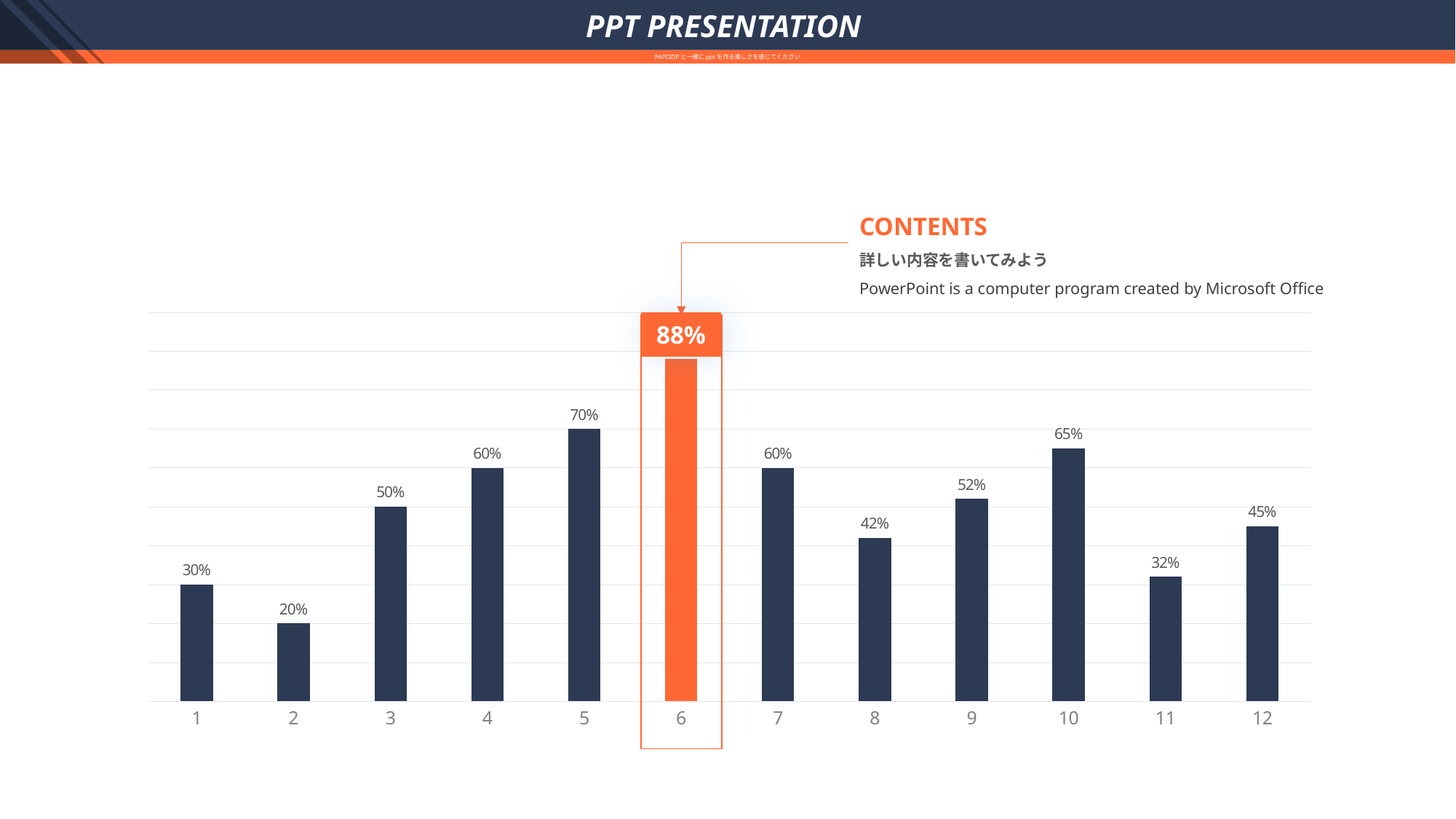
Which category has the lowest value? 2 Which category has the highest value? 6 What is the difference between the values for category 6 and category 5? 18% Which is larger, the value for category 8 or the value for category 9? 9 Which bar is highlighted in orange? 6 Which is larger, the value for category 1 or the value for category 11? 11 What is the difference between the values for category 10 and category 12? 20% How many categories are shown on the x axis? 12 What is the value for category 9? 52% What is the value for category 6? 88% What kind of chart is shown on the slide? bar chart What is the value for category 11? 32%